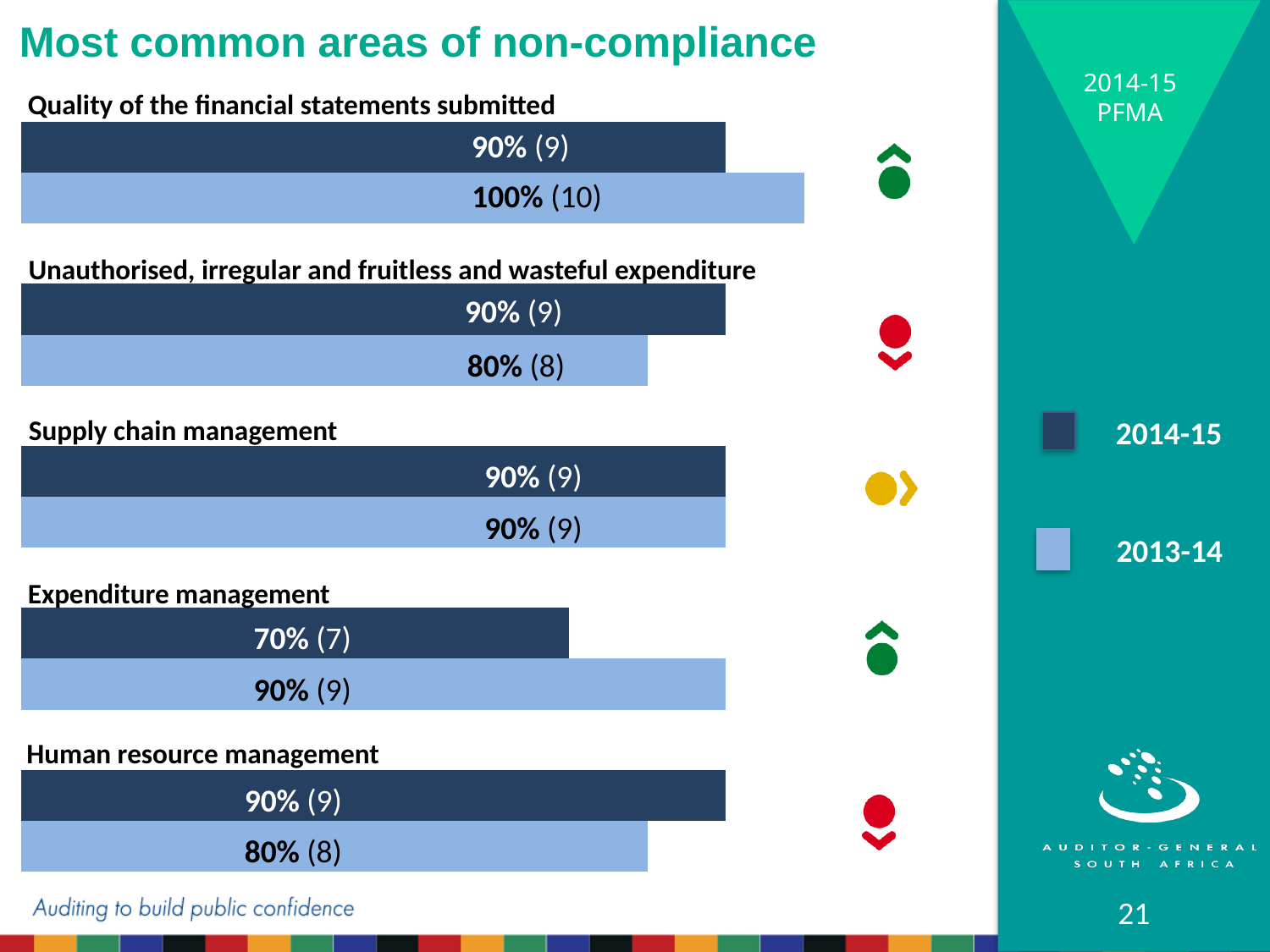
Which area has the highest 2013-14 value? Quality of the financial statements submitted What kind of chart is used on the slide? bar chart How many areas of non-compliance are shown on the slide? 5 What is the 2013-14 value for Quality of the financial statements submitted? 100% (10) How many series does the legend list? 2 For Supply chain management, is the 2014-15 value larger, smaller, or the same as the 2013-14 value? the same What is the difference between the 2013-14 and 2014-15 percentages for Expenditure management? 20% Which area has the lowest 2014-15 value? Expenditure management What is the 2013-14 value for Unauthorised, irregular and fruitless and wasteful expenditure? 80% (8) What is the 2014-15 value for Expenditure management? 70% (7) What is the 2014-15 value for Quality of the financial statements submitted? 90% (9) What is the 2013-14 value for Human resource management? 80% (8)